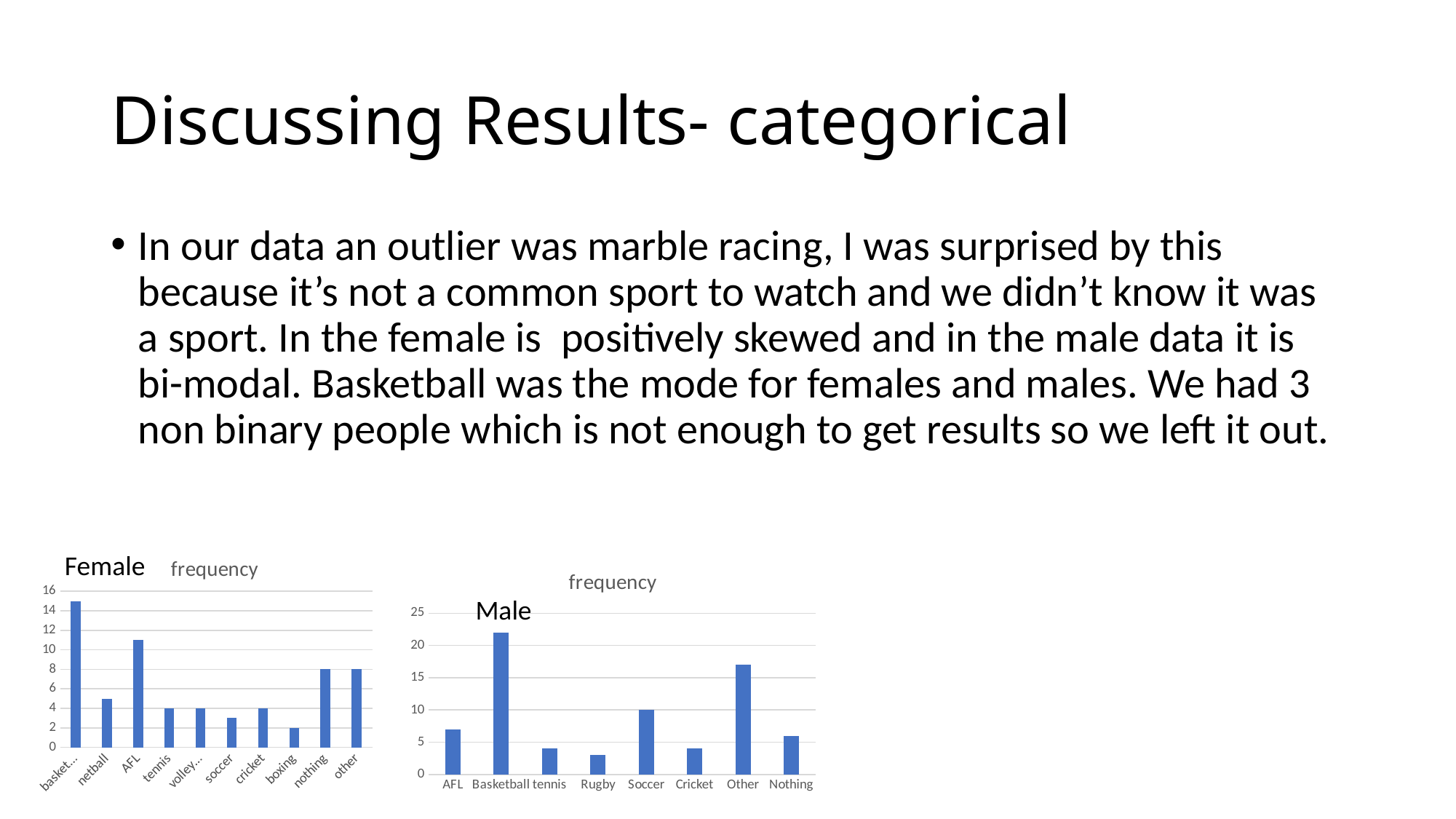
On the Male frequency chart, which category has the highest frequency? Basketball On the Male frequency chart, what is the frequency for Soccer? 10 How many categories are shown on the Male frequency chart? 8 On the Female frequency chart, what is the difference between the frequency for nothing and the frequency for boxing? 6 What kind of chart is the Female frequency chart? bar chart On the Female frequency chart, is the value for AFL greater or less than 10? greater How many categories are shown on the Female frequency chart? 10 On the Female frequency chart, what is the frequency for nothing? 8 On the Female frequency chart, what is the frequency for boxing? 2 On the Male frequency chart, is the value for Other greater or less than 15? greater On the Male frequency chart, which is larger, Basketball or Other? Basketball On the Female frequency chart, which category has the lowest frequency? boxing